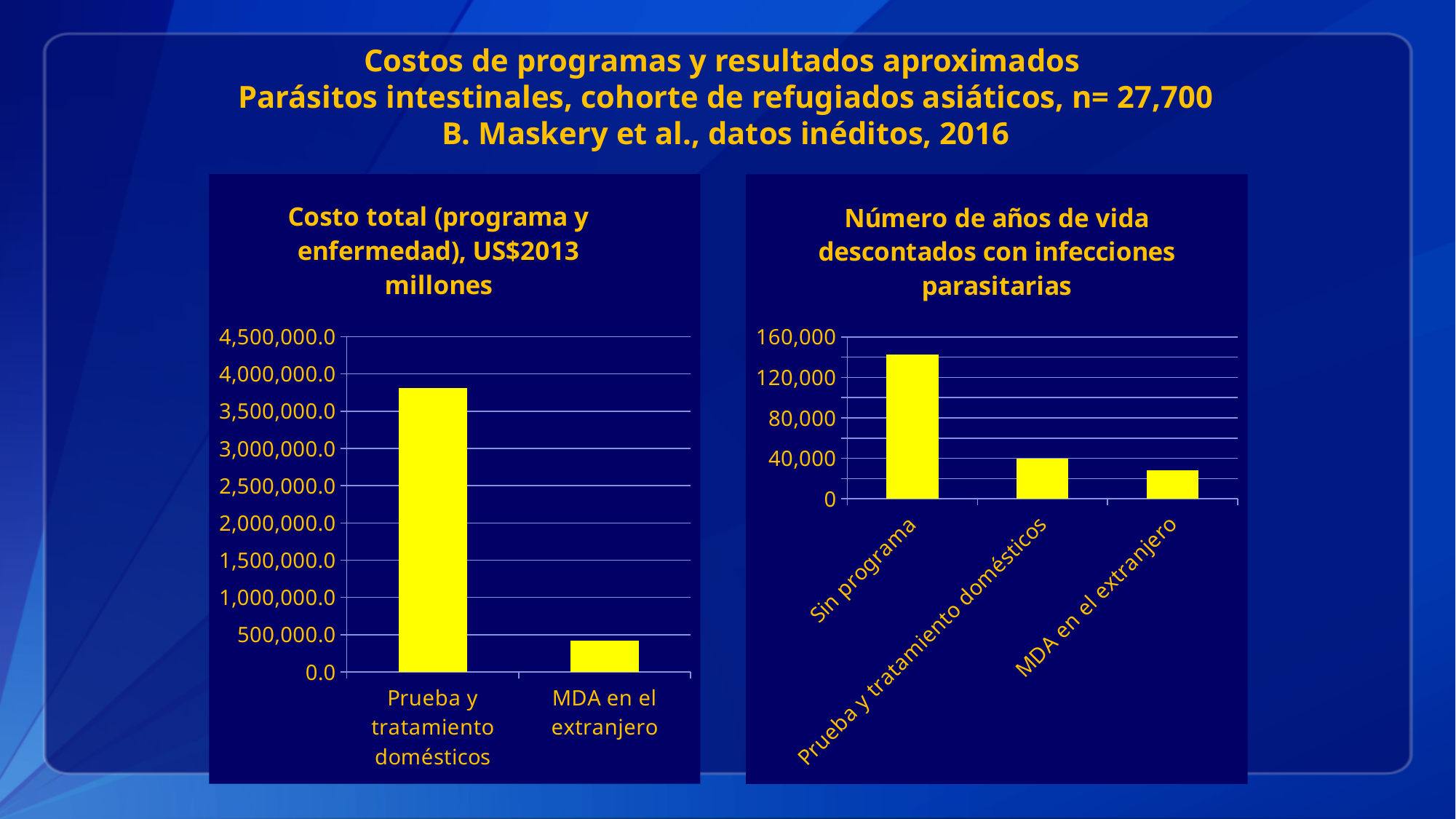
In the right chart (Número de años de vida descontados), is the value for Prueba y tratamiento domésticos greater or less than 80,000? less In the left chart (Costo total), is the value for MDA en el extranjero greater or less than 500,000.0? less In the right chart (Número de años de vida descontados), which category has the highest value? Sin programa In the right chart (Número de años de vida descontados), is the value for Sin programa greater or less than 120,000? greater In the right chart (Número de años de vida descontados), which category has the lowest value? MDA en el extranjero In the left chart (Costo total), which category has the highest value? Prueba y tratamiento domésticos In the right chart (Número de años de vida descontados), do the values rise or fall from left to right along the x axis? fall How many categories are shown in the left chart (Costo total)? 2 In the left chart (Costo total), which category has the lowest value? MDA en el extranjero How many categories are shown in the right chart (Número de años de vida descontados)? 3 What kind of chart is the right chart (Número de años de vida descontados)? bar chart